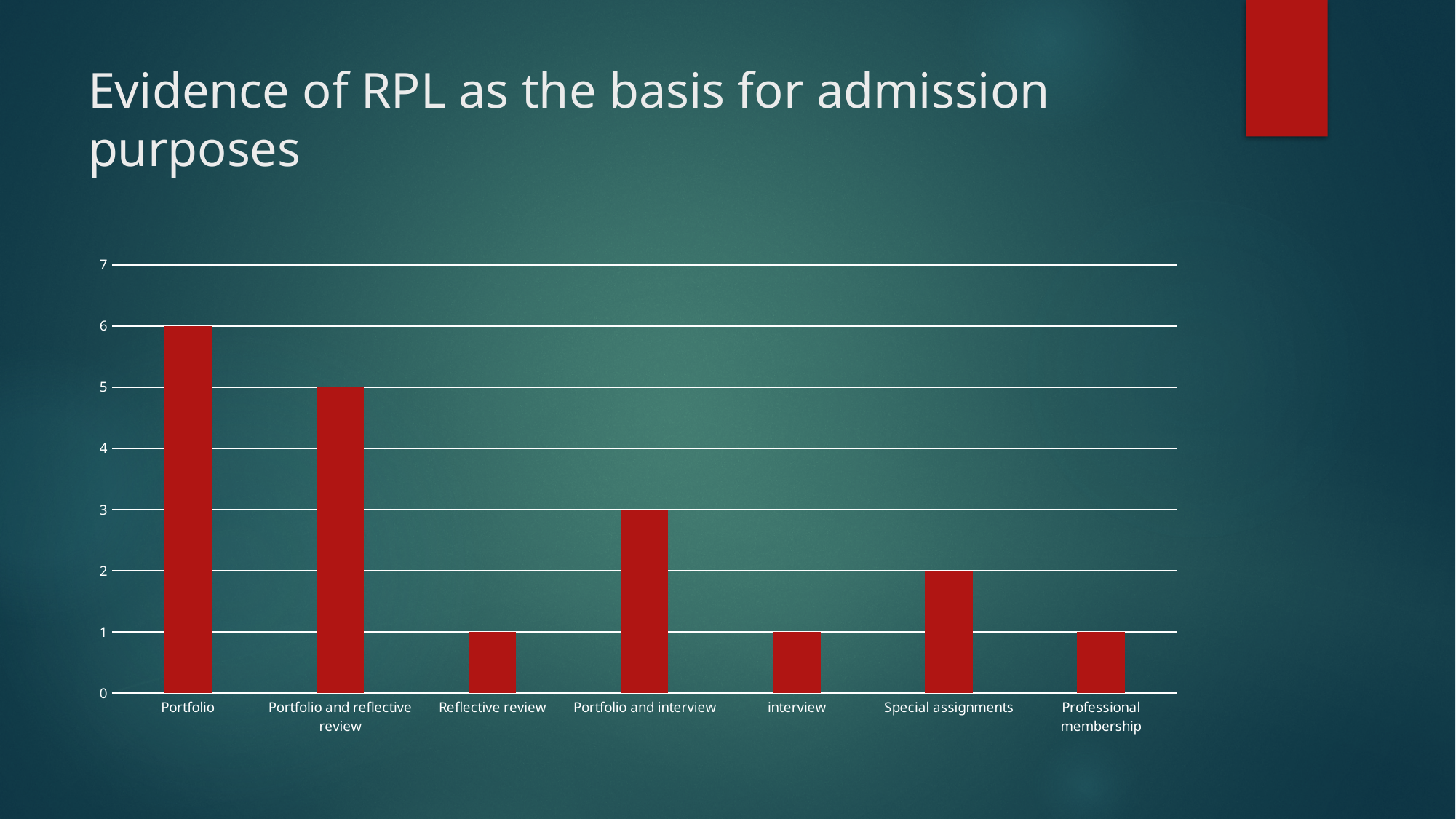
Is the value for Portfolio greater or less than 4? greater Which is larger, the value for Portfolio and interview or the value for Special assignments? Portfolio and interview What kind of chart is shown on the slide? Bar chart How many categories are shown on the x axis? 7 What is the value for Special assignments? 2 What is the title of the slide containing the chart? Evidence of RPL as the basis for admission purposes What is the difference between the values for Portfolio and reflective review and Special assignments? 3 Which category has the highest value? Portfolio What is the value for Portfolio and interview? 3 What is the value for Portfolio and reflective review? 5 What is the value for Portfolio? 6 What is the difference between the values for Portfolio and Portfolio and interview? 3